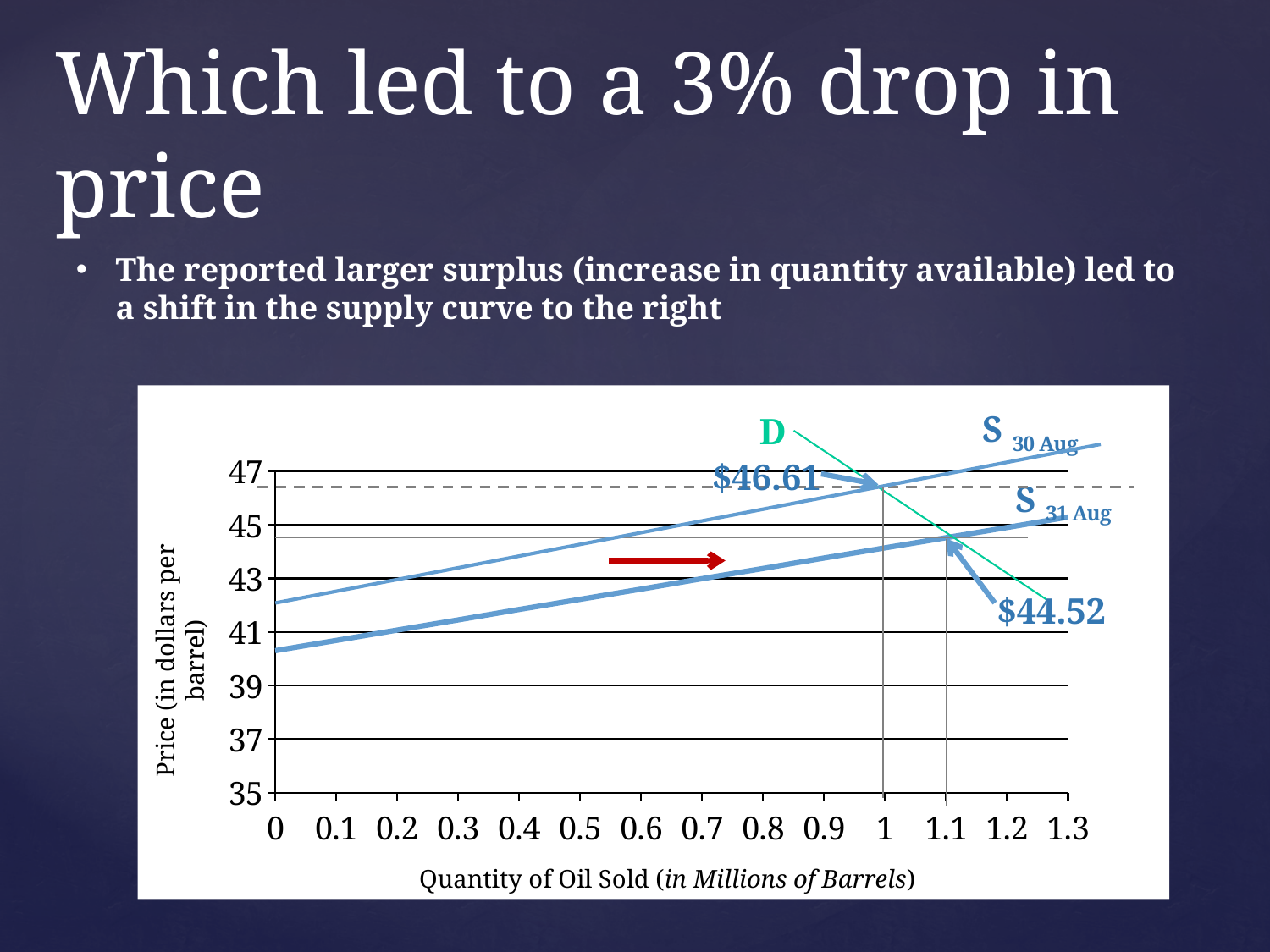
What is the label of the vertical axis? Price (in dollars per barrel) Is the price on the S 31 Aug curve at quantity 0 greater or less than 41? less Does the demand curve D rise or fall as quantity increases along the x axis? fall What is the equilibrium price where the demand curve D meets the S 30 Aug supply curve? $46.61 What is the equilibrium price where the demand curve D meets the S 31 Aug supply curve? $44.52 Do the supply curves rise or fall as quantity increases along the x axis? rise At what quantity (in millions of barrels) does the demand curve intersect the S 31 Aug supply curve? 1.1 What is the difference between the two labelled equilibrium prices, $46.61 and $44.52? $2.09 At what quantity (in millions of barrels) does the demand curve intersect the S 30 Aug supply curve? 1 What is the label of the horizontal axis? Quantity of Oil Sold (in Millions of Barrels) What kind of chart is shown on the slide? line chart Which supply curve gives the higher equilibrium price, S 30 Aug or S 31 Aug? S 30 Aug